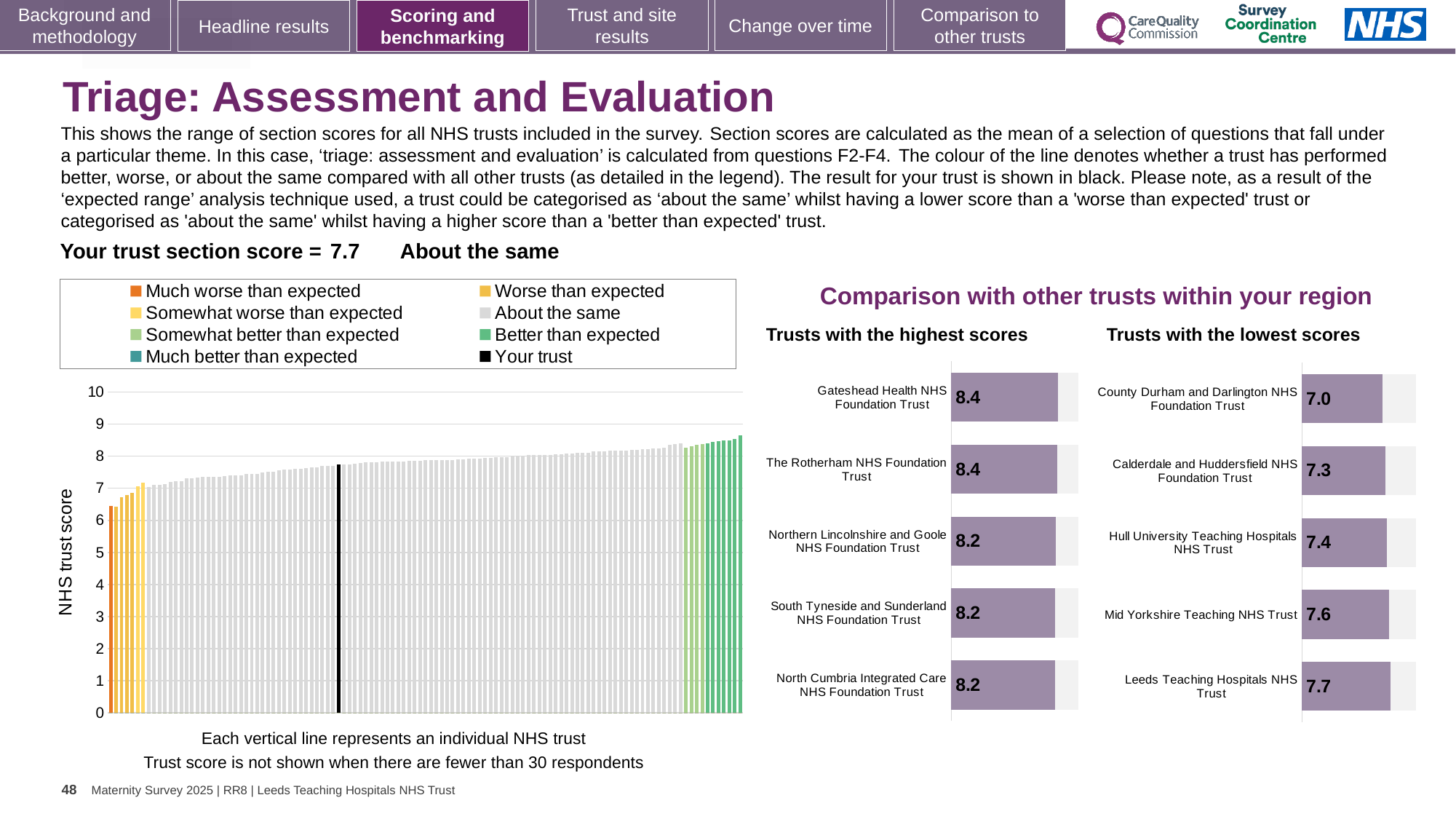
How many trusts are shown in the 'Trusts with the highest scores' chart? 5 How many entries does the legend of the 'NHS trust score' chart list? 8 In the 'Trusts with the highest scores' chart, what is the score for North Cumbria Integrated Care NHS Foundation Trust? 8.2 In the 'NHS trust score' chart on the left, do the values rise or fall from left to right? Rise In the 'Trusts with the lowest scores' chart, what is the score for County Durham and Darlington NHS Foundation Trust? 7.0 In the 'Trusts with the lowest scores' chart, which trust has the lowest score? County Durham and Darlington NHS Foundation Trust In the 'Trusts with the lowest scores' chart, which trust has the highest score? Leeds Teaching Hospitals NHS Trust In the 'Trusts with the lowest scores' chart, which has the higher score: Calderdale and Huddersfield NHS Foundation Trust or Hull University Teaching Hospitals NHS Trust? Hull University Teaching Hospitals NHS Trust In the 'Trusts with the lowest scores' chart, what is the difference between the scores of Leeds Teaching Hospitals NHS Trust and County Durham and Darlington NHS Foundation Trust? 0.7 In the 'Trusts with the highest scores' chart, what is the score for Gateshead Health NHS Foundation Trust? 8.4 What kind of chart is the large 'NHS trust score' chart on the left? Bar chart In the 'NHS trust score' chart on the left, is the value of the leftmost (orange) bar greater or less than 7? less